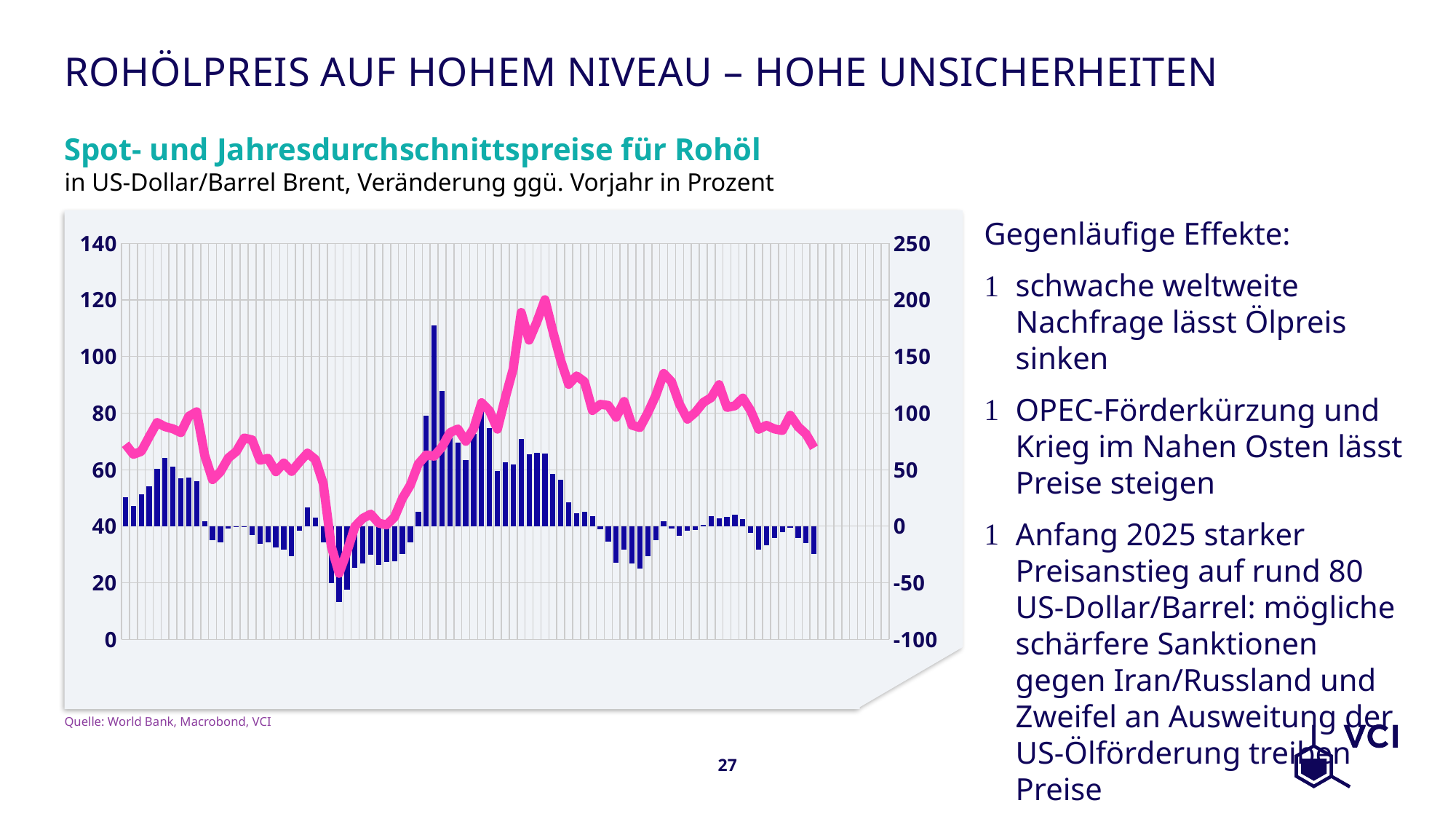
Is the tallest blue bar greater or less than 150 on the right axis? greater What is the title of the chart? Spot- und Jahresdurchschnittspreise für Rohöl What kind of chart is shown on the slide? A combined bar and line chart Is the peak value of the pink line greater or less than 100 on the left axis? greater What source is cited below the chart? World Bank, Macrobond, VCI Is the lowest value of the pink line greater or less than 40 on the left axis? less What is the lowest tick value on the right vertical axis of the chart? -100 What is the highest tick value on the right vertical axis of the chart? 250 What is the highest tick value on the left vertical axis of the chart? 140 How many data series are plotted in the chart? 2 Does the pink line rise or fall over the last few points at the right end of the chart? fall